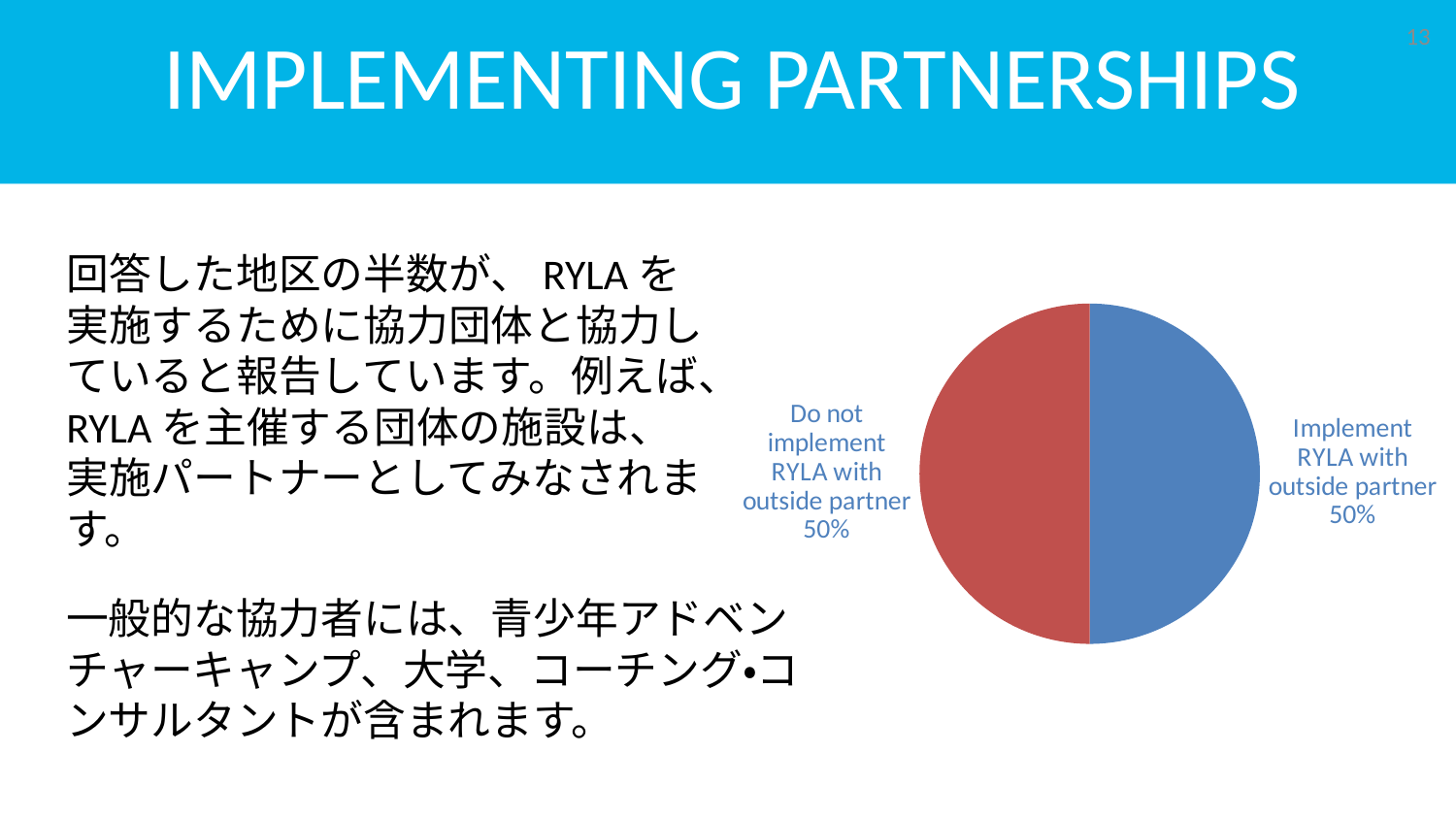
What is the total of the two slices shown in the pie chart? 100% What kind of chart is shown on the slide? pie chart What share of the pie is labelled "Implement RYLA with outside partner"? 50% Which colour is the "Implement RYLA with outside partner" slice? blue Which colour is the "Do not implement RYLA with outside partner" slice? red What share of the pie is labelled "Do not implement RYLA with outside partner"? 50% How many slices does the pie chart have? 2 What is the difference between the "Implement RYLA with outside partner" share and the "Do not implement RYLA with outside partner" share? 0%